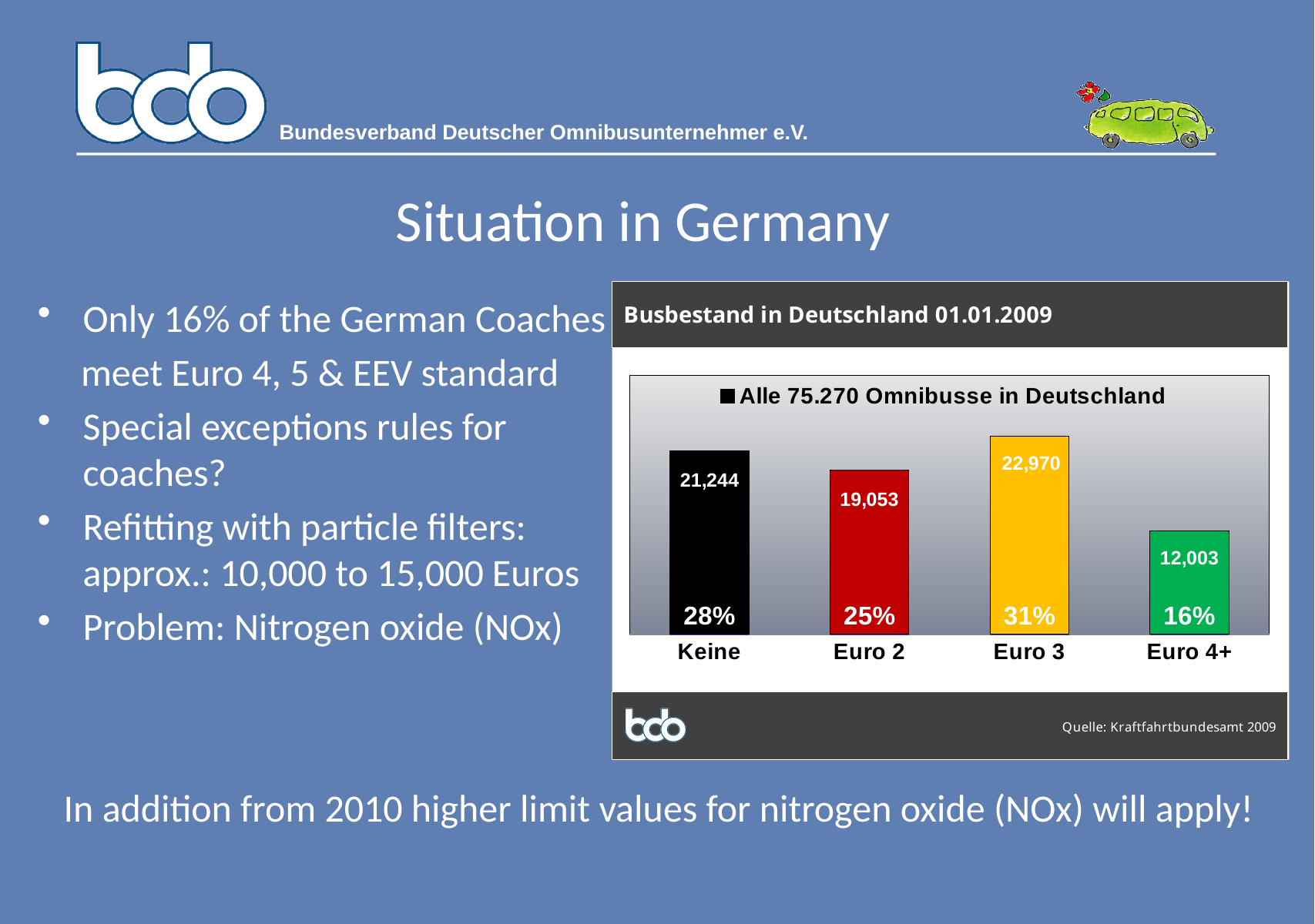
What kind of chart is shown? bar chart What is the value for Euro 3 in the chart? 22,970 Which category has the highest value? Euro 3 What is the title of the chart? Busbestand in Deutschland 01.01.2009 What is the difference between the values for Keine and Euro 4+? 9,241 What is the value for Keine in the chart? 21,244 What is the difference between the values for Euro 3 and Euro 2? 3,917 Which is larger, the value for Keine or the value for Euro 2? Keine How many series does the legend list? 1 How many categories are shown on the x axis? 4 What percentage is shown for Euro 4+? 16% Which category has the lowest value? Euro 4+